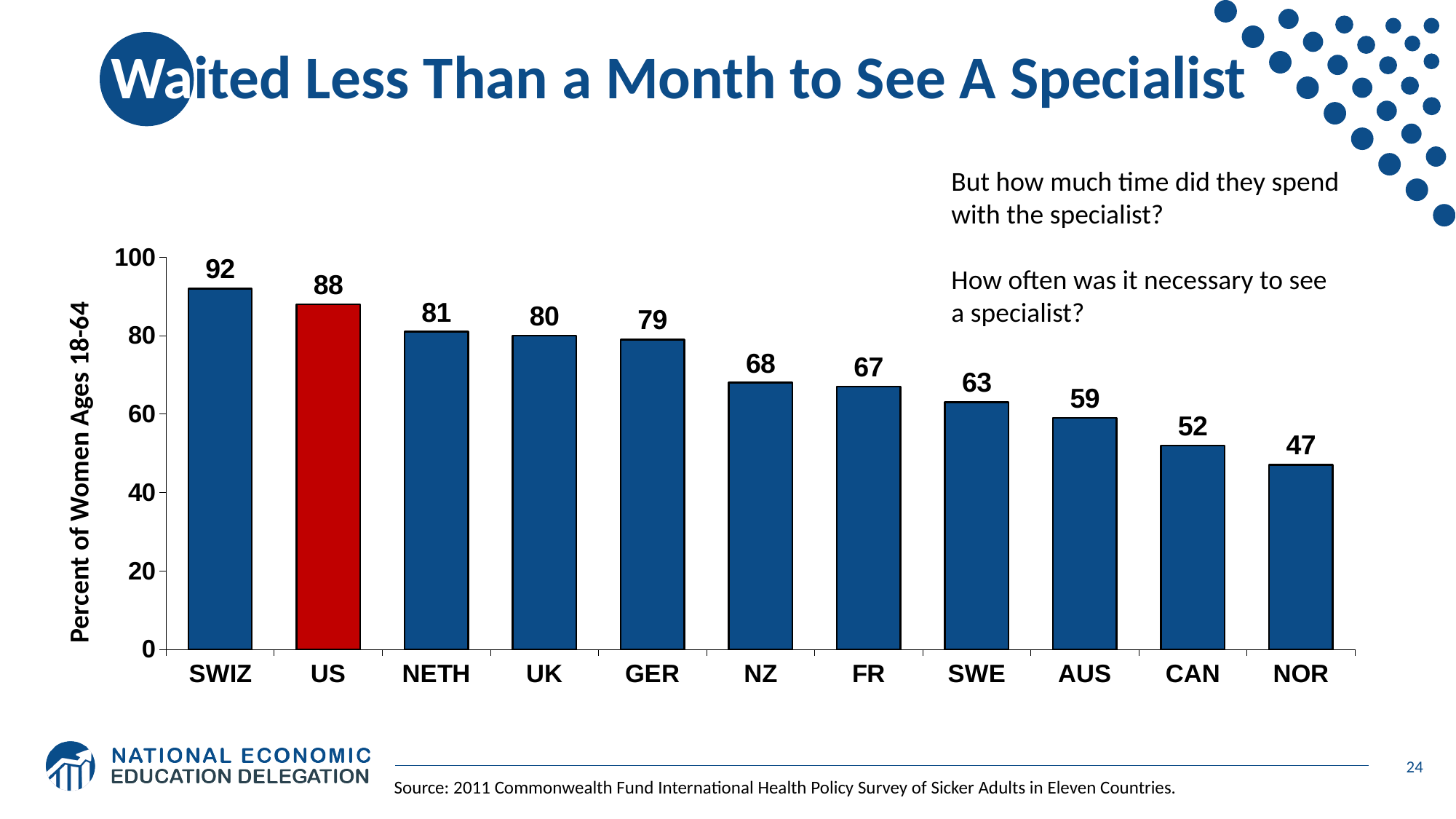
Which country has the lowest value? NOR What is the value for NOR? 47 What kind of chart is shown on the slide? bar chart Is the value for AUS greater or less than 60? less What is the difference between the values for SWIZ and the US? 4 Which country has the highest value? SWIZ What is the value for GER? 79 How many countries are shown on the chart? 11 What is the difference between the values for NETH and CAN? 29 Which bar is coloured red rather than blue? US Which has a larger value, NZ or SWE? NZ What is the value for the US? 88